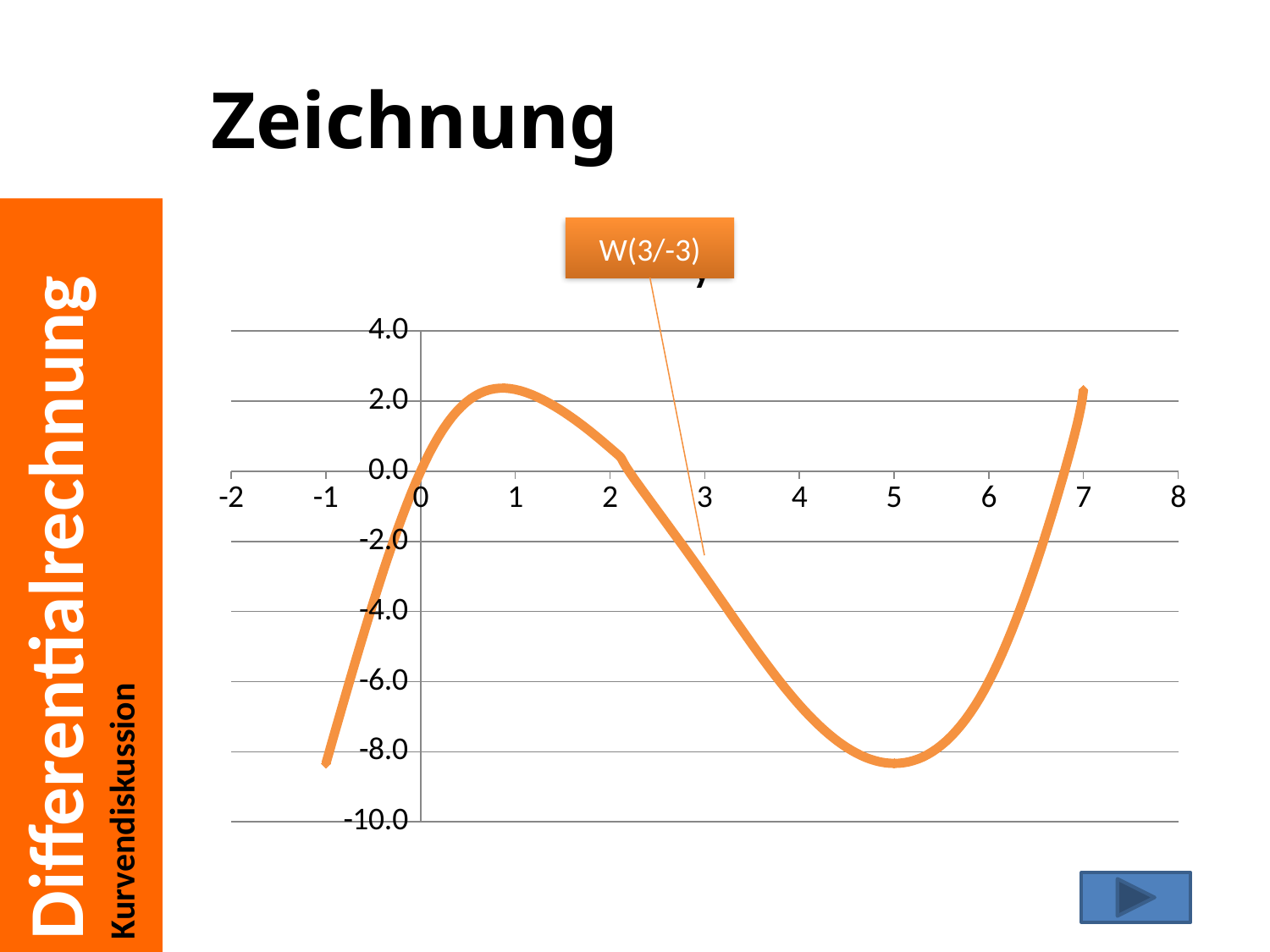
What are the coordinates of the point W marked by the callout? (3/-3) Is the value of the curve at x = 3 larger or smaller than the value at x = 1? smaller Does the curve rise or fall between x = 5 and x = 7? rise What kind of chart is shown on the slide? line chart Is the value of the curve at x = 3 greater or less than -2.0? less Is the value of the curve at x = 1 greater or less than 2.0? greater Does the curve rise or fall between x = 1 and x = 5? fall Is the value of the curve at x = 6 greater or less than -4.0? less What colour is the plotted curve? orange What is the lowest value shown on the y axis? -10.0 What label is shown in the callout box pointing at the curve? W(3/-3)